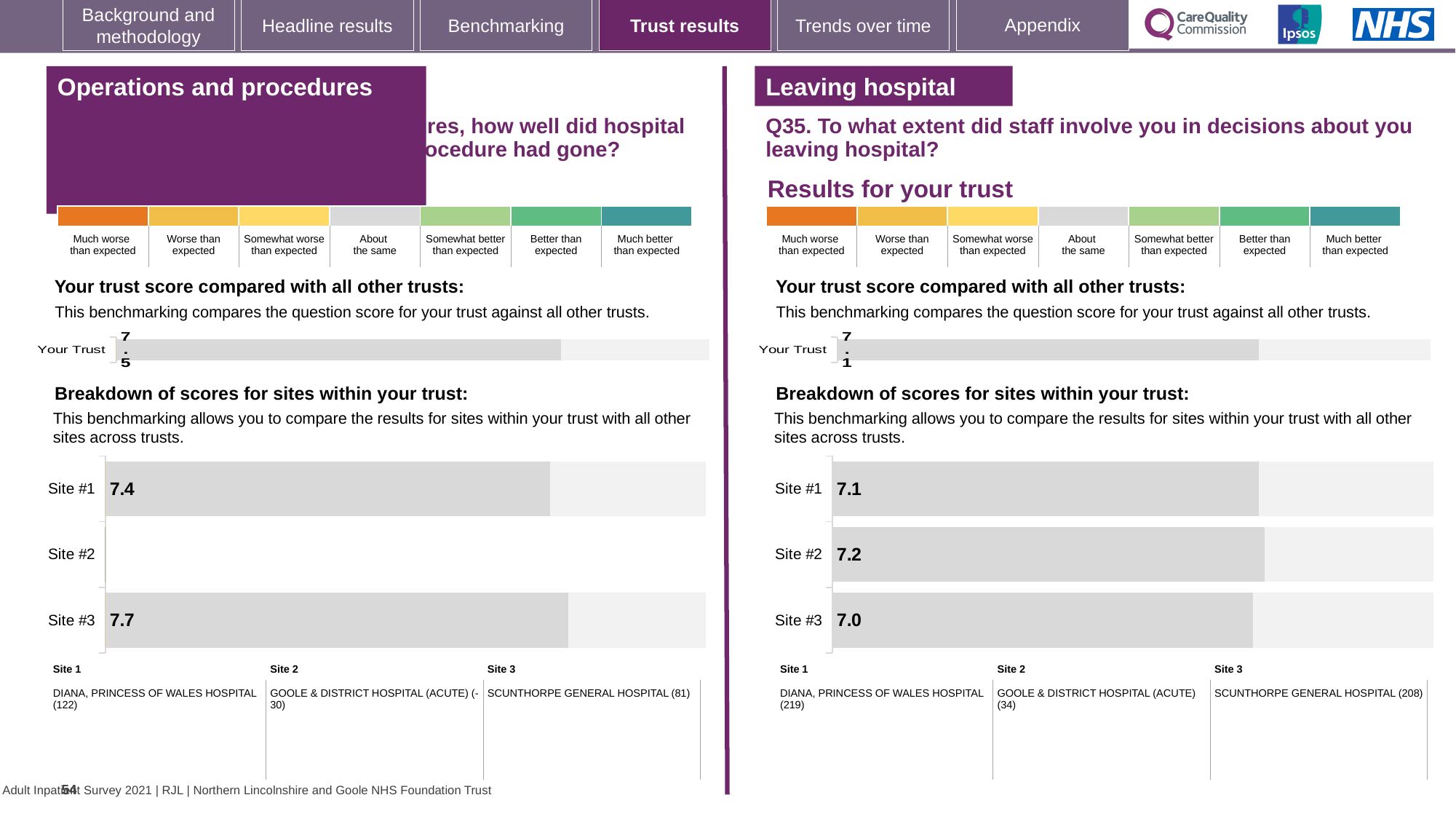
Comparing the Your Trust scores, which section has the higher score: Operations and procedures (left) or Leaving hospital (right)? Operations and procedures In the site breakdown chart on the right (Leaving hospital), what is the score for Site #2? 7.2 In the site breakdown chart on the left (Operations and procedures), what is the score for Site #3? 7.7 In the site breakdown chart on the right (Leaving hospital), which site has the lowest score? Site #3 What type of chart is used for the site breakdown on the right (Leaving hospital)? Bar chart In the 'Operations and procedures' section on the left, what is the score shown for Your Trust? 7.5 In the site breakdown chart on the left (Operations and procedures), what is the score for Site #1? 7.4 In the site breakdown chart on the right (Leaving hospital), what is the difference between the scores for Site #2 and Site #3? 0.2 In the site breakdown chart on the left (Operations and procedures), what is the difference between the scores for Site #3 and Site #1? 0.3 In the 'Leaving hospital' section on the right, what is the score shown for Your Trust? 7.1 How many sites are listed in the site breakdown chart on the right (Leaving hospital)? 3 In the site breakdown chart on the right (Leaving hospital), which site has the highest score? Site #2